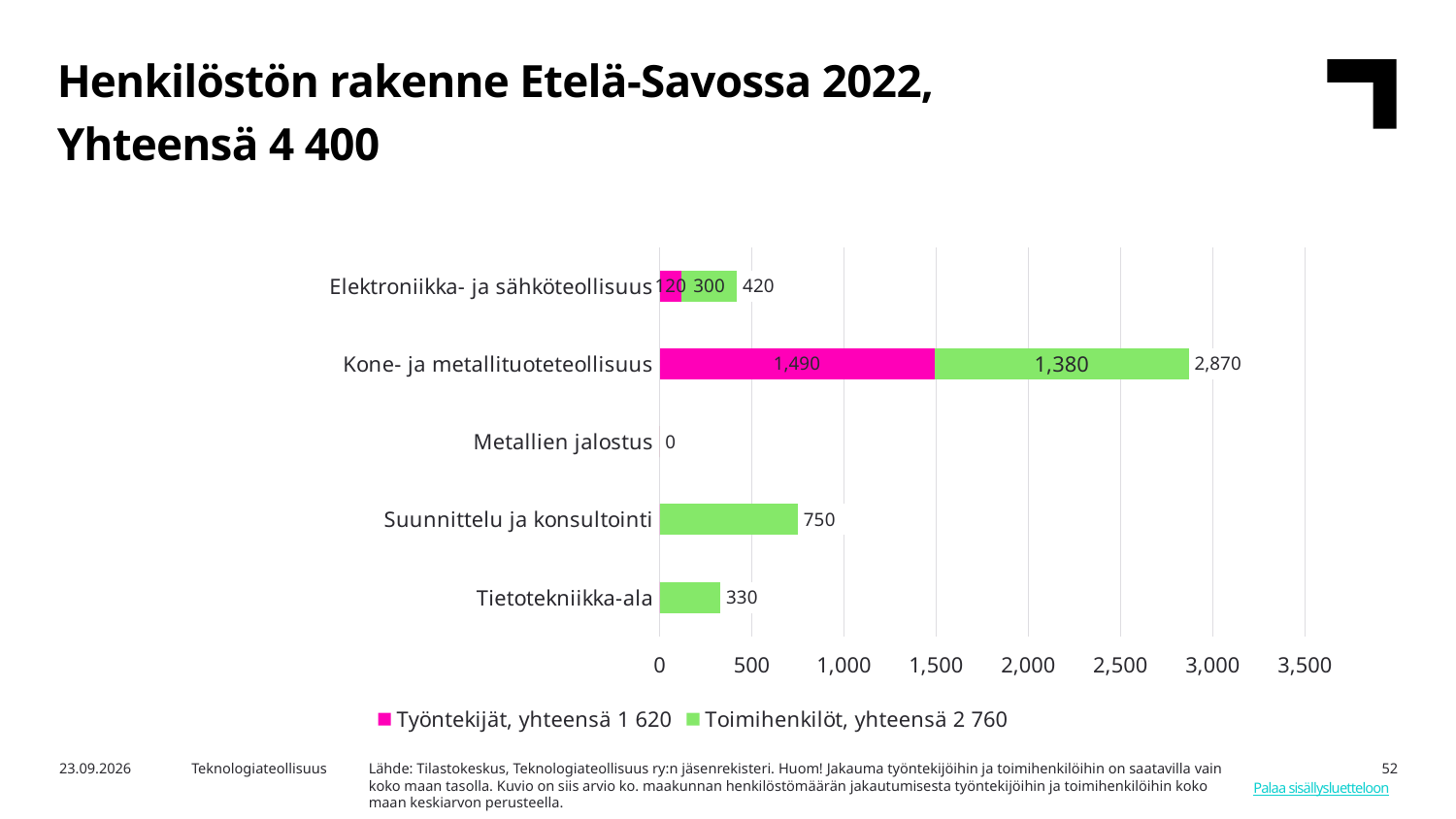
Which category has the highest total value? Kone- ja metallituoteteollisuus What kind of chart is shown on the slide? Stacked bar chart Which is larger: the total for Elektroniikka- ja sähköteollisuus or the total for Suunnittelu ja konsultointi? Suunnittelu ja konsultointi What is the difference between the total for Suunnittelu ja konsultointi and the total for Tietotekniikka-ala? 420 What is the value for Tietotekniikka-ala? 330 What is the total value for Kone- ja metallituoteteollisuus? 2,870 How many categories are shown on the chart? 5 How many series does the legend list? 2 Which category has the lowest total value? Metallien jalostus What is the value for Suunnittelu ja konsultointi? 750 What is the Työntekijät value for Kone- ja metallituoteteollisuus? 1,490 What is the Toimihenkilöt value for Kone- ja metallituoteteollisuus? 1,380